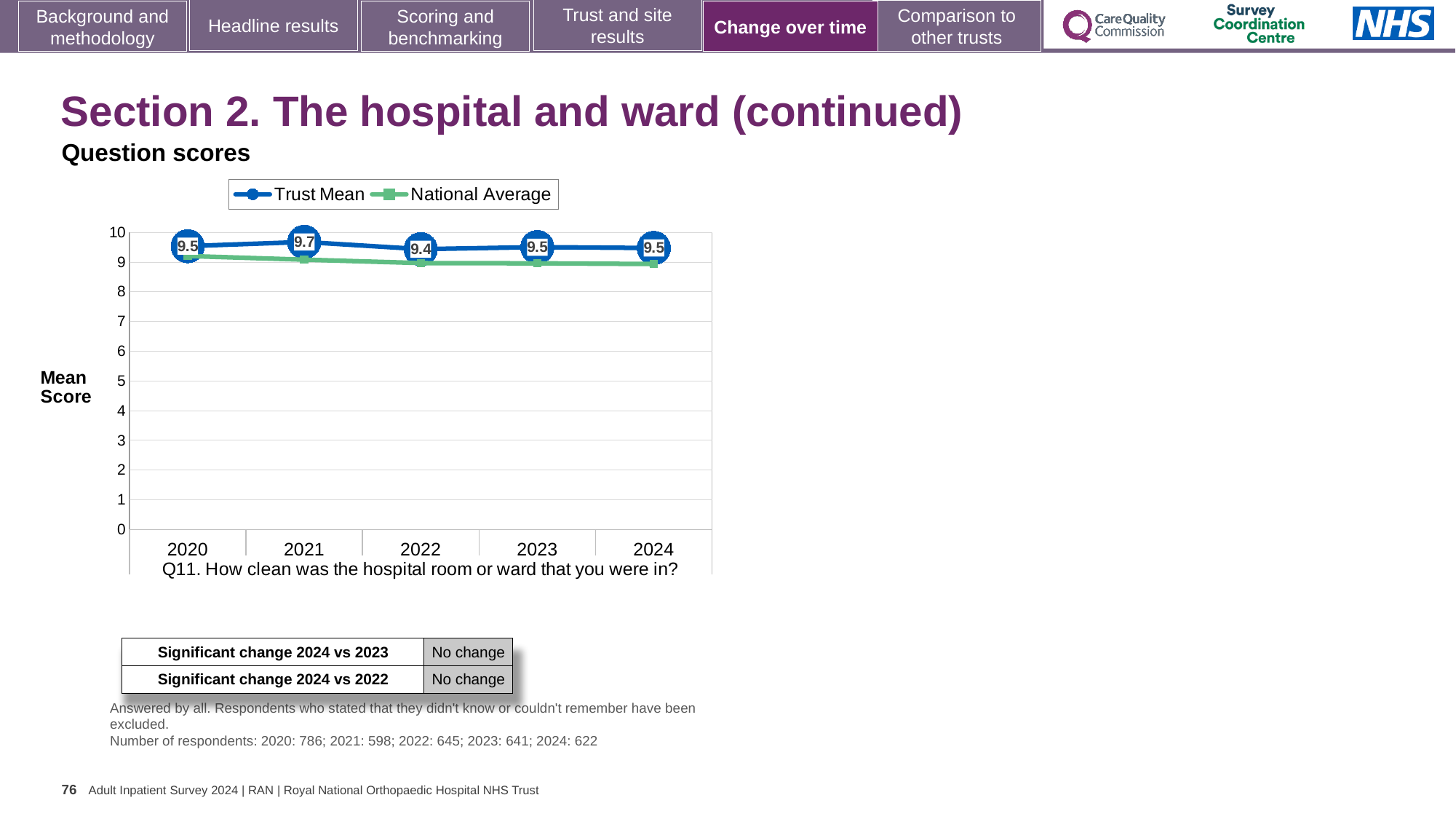
In which year is the Trust Mean highest? 2021 Which survey question does the chart show scores for? Q11. How clean was the hospital room or ward that you were in? What kind of chart is shown? Line chart What is the Trust Mean value for 2021? 9.7 What is the difference between the Trust Mean in 2021 and in 2022? 0.3 How many series does the legend list? 2 Which is larger in 2023, the Trust Mean or the National Average? Trust Mean In which year is the Trust Mean lowest? 2022 What is the Trust Mean value for 2022? 9.4 Is the National Average value for 2024 greater or less than 8? greater What is the Trust Mean value for 2024? 9.5 How many years are shown on the x axis? 5